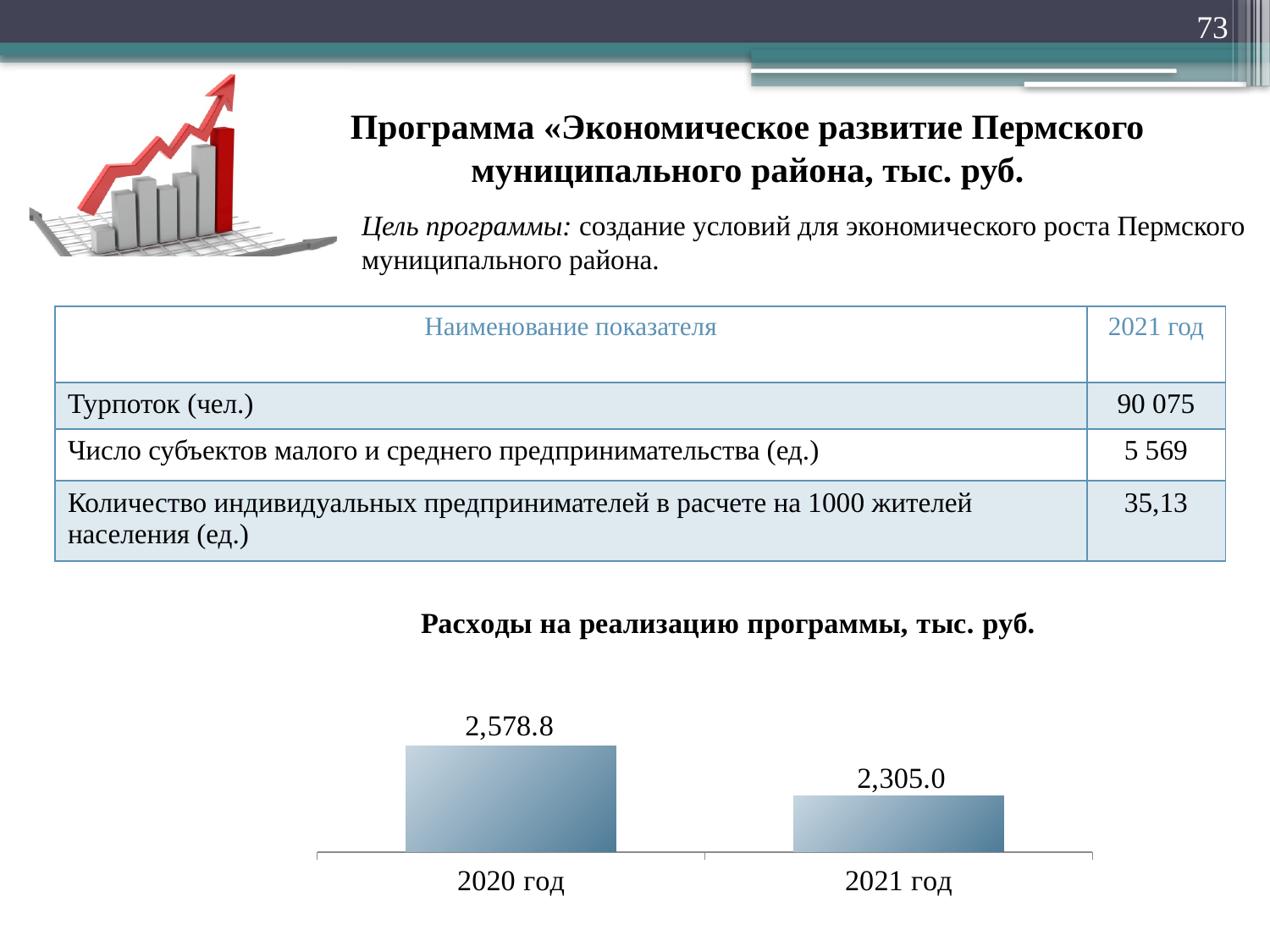
What is the difference between the 2020 год and 2021 год values in the chart 'Расходы на реализацию программы, тыс. руб.'? 273.8 What unit is stated in the title of the chart at the bottom of the slide? тыс. руб. In the chart 'Расходы на реализацию программы, тыс. руб.', which is larger: the value for 2020 год or for 2021 год? 2020 год How many categories are shown in the chart 'Расходы на реализацию программы, тыс. руб.'? 2 What is the value for 2021 год in the chart 'Расходы на реализацию программы, тыс. руб.'? 2,305.0 Which year has the highest value in the chart 'Расходы на реализацию программы, тыс. руб.'? 2020 год Which year has the lowest value in the chart 'Расходы на реализацию программы, тыс. руб.'? 2021 год What is the value for 2020 год in the chart 'Расходы на реализацию программы, тыс. руб.'? 2,578.8 What is the title of the chart at the bottom of the slide? Расходы на реализацию программы, тыс. руб. What kind of chart is 'Расходы на реализацию программы, тыс. руб.'? bar chart Do the values rise or fall from 2020 год to 2021 год in the chart 'Расходы на реализацию программы, тыс. руб.'? fall